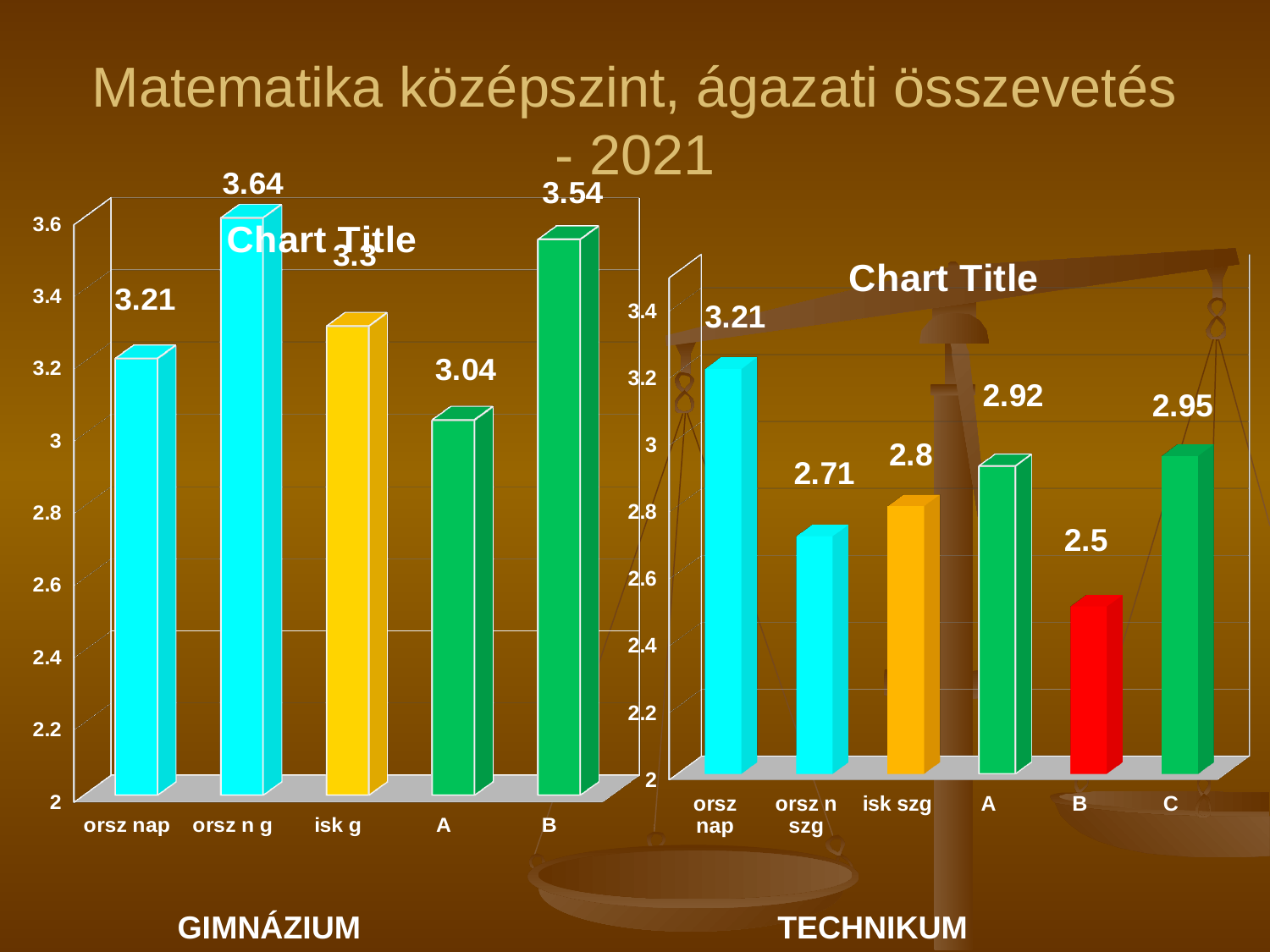
In the left chart (GIMNÁZIUM), how many categories are shown? 5 What kind of chart is the right chart (TECHNIKUM)? bar chart In the left chart (GIMNÁZIUM), which category has the lowest value? A In the right chart (TECHNIKUM), what is the value for isk szg? 2.8 In the right chart (TECHNIKUM), which category has the lowest value? B In the right chart (TECHNIKUM), how many categories are shown? 6 In the right chart (TECHNIKUM), what is the value for C? 2.95 In the left chart (GIMNÁZIUM), which category has the highest value? orsz n g In the left chart (GIMNÁZIUM), what is the value for A? 3.04 In the left chart (GIMNÁZIUM), what is the difference between the values for B and isk g? 0.24 In the left chart (GIMNÁZIUM), what is the value for orsz n g? 3.64 In the right chart (TECHNIKUM), which is larger, the value for A or the value for orsz n szg? A